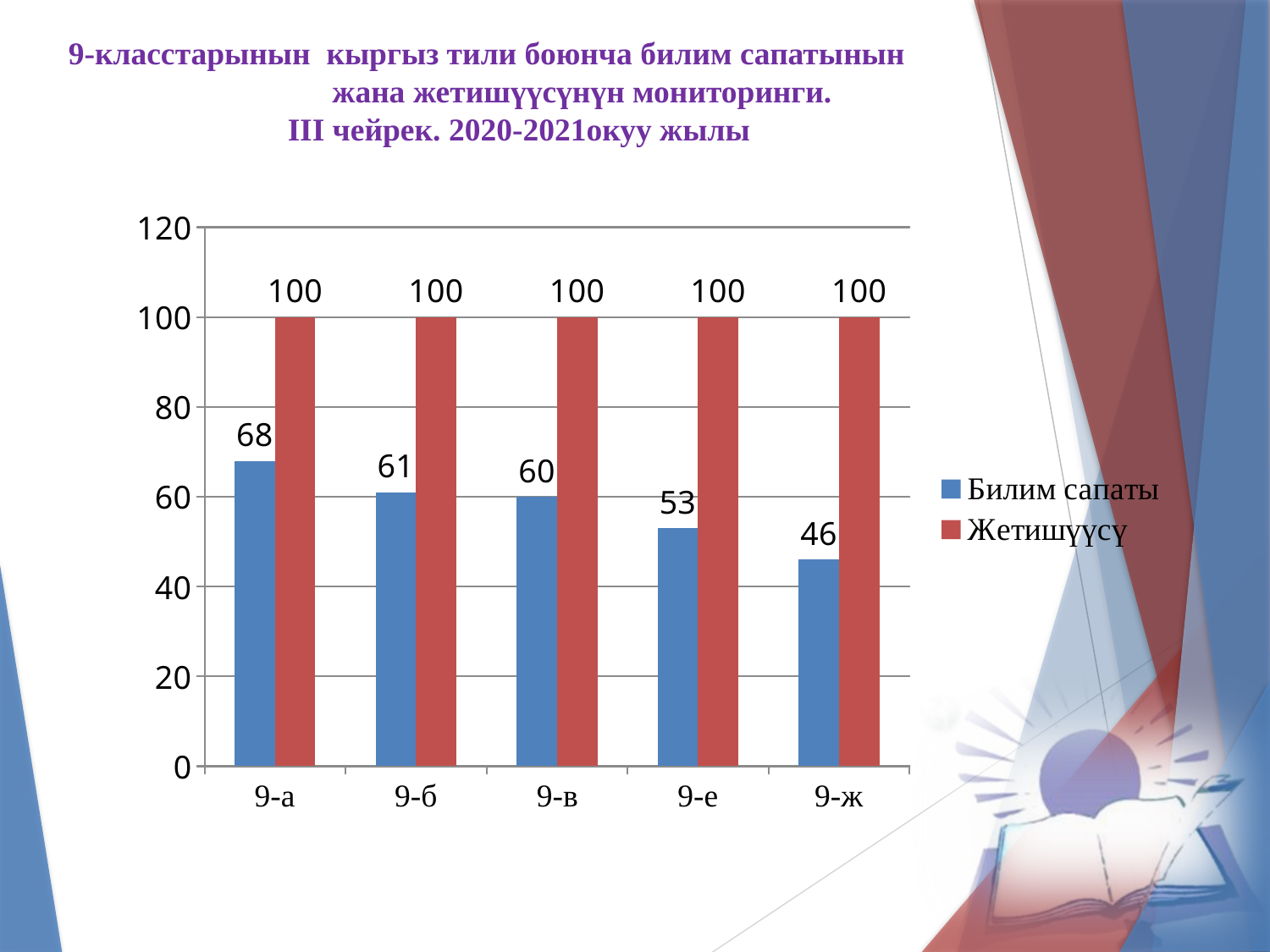
What is the value of Билим сапаты for 9-ж? 46 What is the difference between the Билим сапаты values for 9-а and 9-ж? 22 Do the Билим сапаты values rise or fall from 9-а to 9-ж? Fall What is the value of Билим сапаты for 9-а? 68 How many categories are shown on the x axis? 5 What is the difference between Жетишүүсү and Билим сапаты for 9-е? 47 What is the value of Жетишүүсү for 9-в? 100 How many series does the legend list? 2 Which category has the lowest Билим сапаты value? 9-ж Which is larger, the Билим сапаты value for 9-б or for 9-е? 9-б What kind of chart is shown on the slide? Bar chart Which category has the highest Билим сапаты value? 9-а